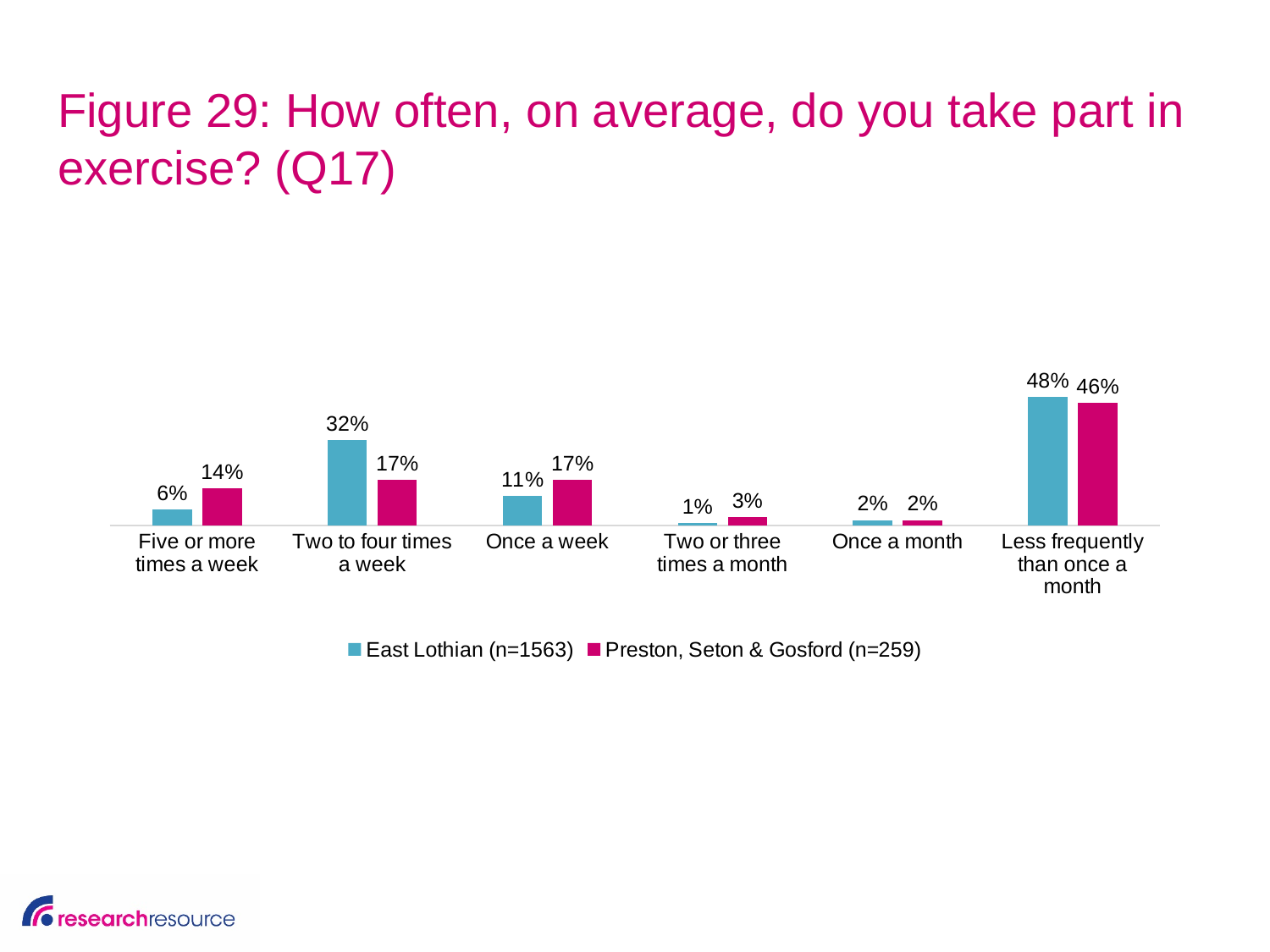
What kind of chart is shown on the slide? Bar chart What percentage of East Lothian respondents take part in exercise two to four times a week? 32% Which category has the lowest value for Preston, Seton & Gosford? Once a month For 'Less frequently than once a month', which series has the larger value? East Lothian (n=1563) What is the difference between East Lothian and Preston, Seton & Gosford for 'Two to four times a week'? 15 percentage points How many series does the legend list? 2 How many categories are shown on the x axis? 6 Which category has the highest value for East Lothian? Less frequently than once a month What is the value for Preston, Seton & Gosford for 'Once a week'? 17% What is the difference between the two series for 'Two or three times a month'? 2 percentage points What is the sample size for Preston, Seton & Gosford shown in the legend? n=259 What percentage of Preston, Seton & Gosford respondents take part in exercise five or more times a week? 14%